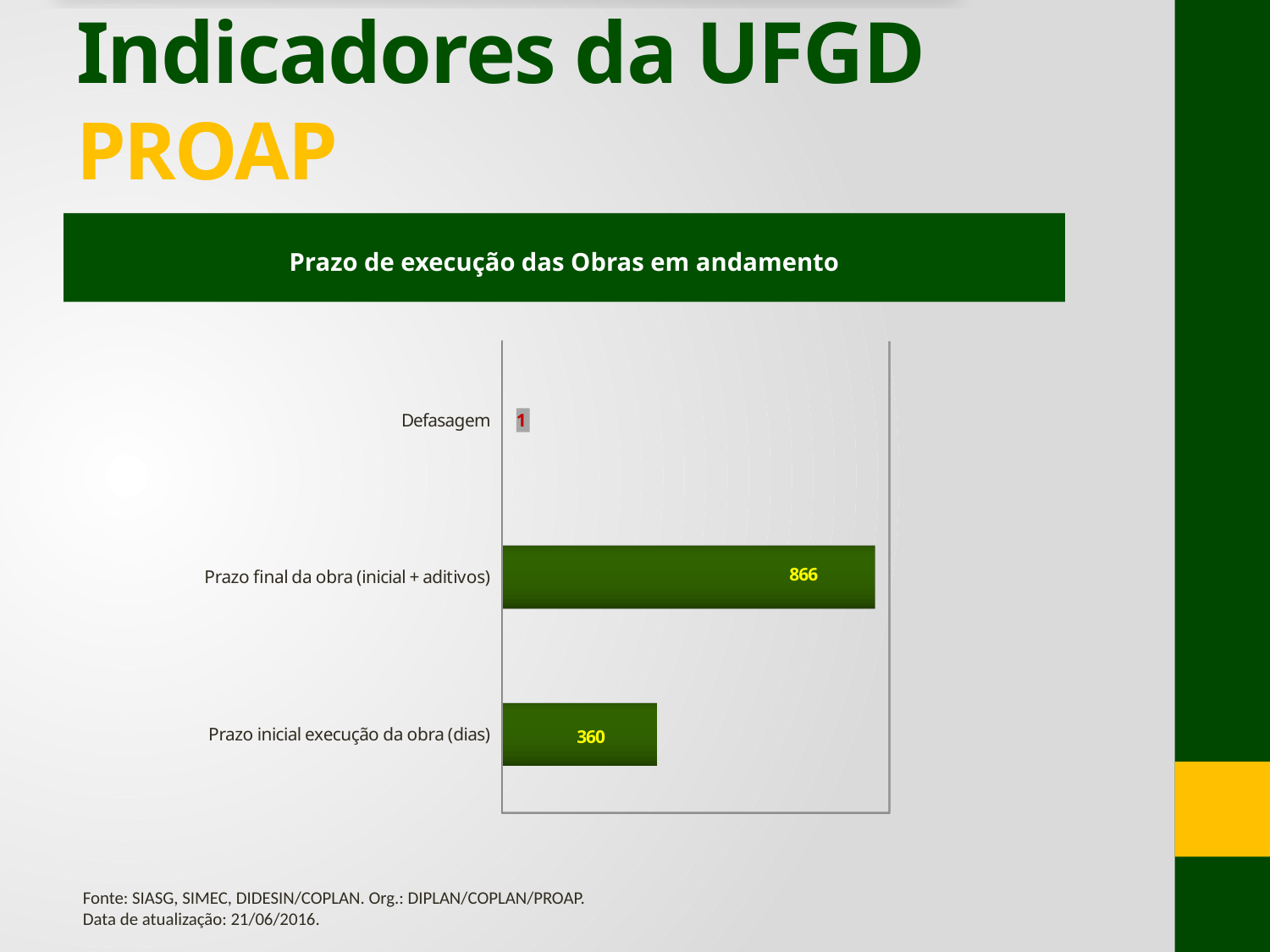
What is the difference between the values for "Prazo final da obra (inicial + aditivos)" and "Prazo inicial execução da obra (dias)"? 506 What kind of chart is shown on the slide? Bar chart Which category has the highest value? Prazo final da obra (inicial + aditivos) Which category has the lowest value? Defasagem What colour are the bars in the chart? Dark green What is the value for "Prazo inicial execução da obra (dias)"? 360 What is the title shown above the chart? Prazo de execução das Obras em andamento Which is larger, the value for "Prazo inicial execução da obra (dias)" or the value for "Defasagem"? Prazo inicial execução da obra (dias) What is the value for "Prazo final da obra (inicial + aditivos)"? 866 How many categories are shown in the chart? 3